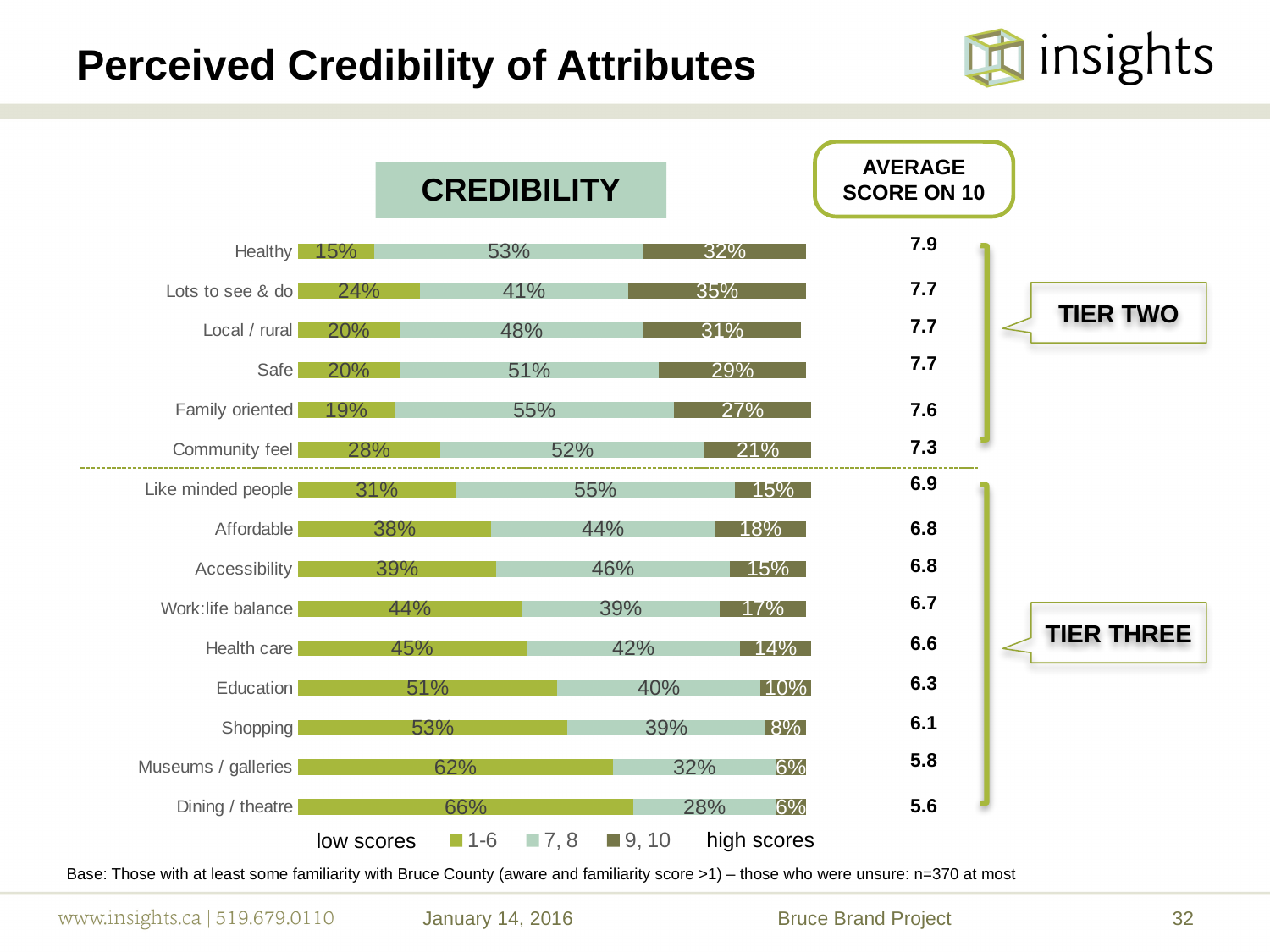
What percentage gave a low score (1-6) for 'Dining / theatre'? 66% How many attributes are plotted in the chart? 15 What is the '7, 8' percentage for 'Family oriented'? 55% For 'Education', how many percentage points higher is the 1-6 share than the 7, 8 share? 11 percentage points Which attribute has the lowest percentage of 1-6 scores? Healthy How many series does the legend list? 3 Which has a larger 1-6 share: 'Affordable' or 'Accessibility'? Accessibility Which attribute has the highest percentage of 9, 10 scores? Lots to see & do What is the average score on 10 shown for 'Community feel'? 7.3 What percentage of respondents gave a score of 9 or 10 for the 'Healthy' attribute? 32% What are the three legend entries of the chart? 1-6, 7, 8, and 9, 10 What type of chart is shown on the slide? Stacked bar chart